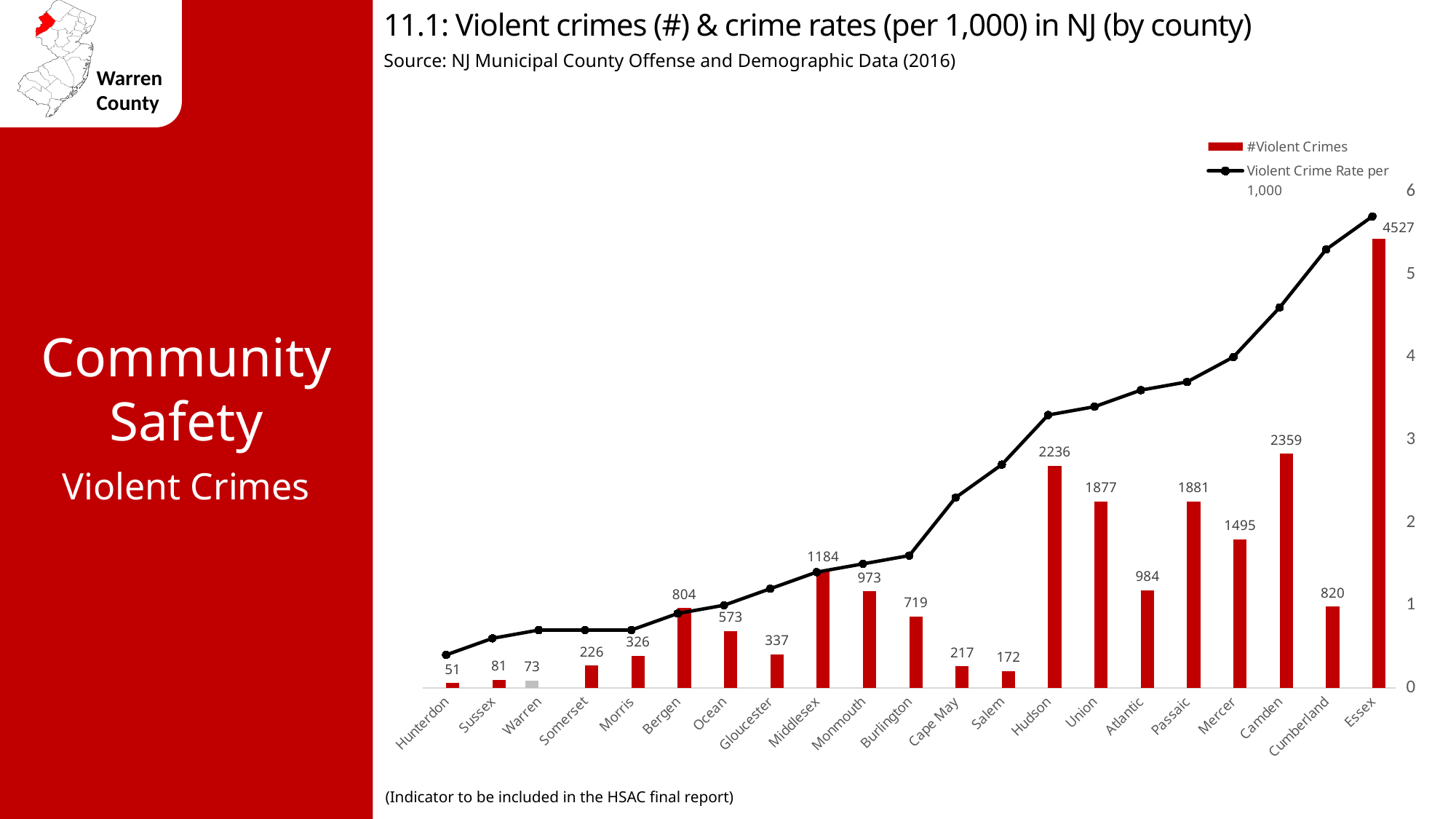
What is the difference in the number of violent crimes between Camden and Hudson? 123 Which county's bar is drawn in grey instead of red? Warren Is the violent crime rate per 1,000 for Hunterdon greater or less than 1? less What is the number of violent crimes shown for Essex County? 4527 Which county has the highest number of violent crimes? Essex How many series does the legend list? 2 Which county has more violent crimes, Passaic or Union? Passaic Which county has the lowest number of violent crimes? Hunterdon How many counties are shown on the x axis of the chart? 21 Is the violent crime rate per 1,000 for Essex greater or less than 5? greater How many violent crimes does the chart show for Warren County? 73 Does the violent crime rate per 1,000 line generally rise or fall from Hunterdon to Essex? rise